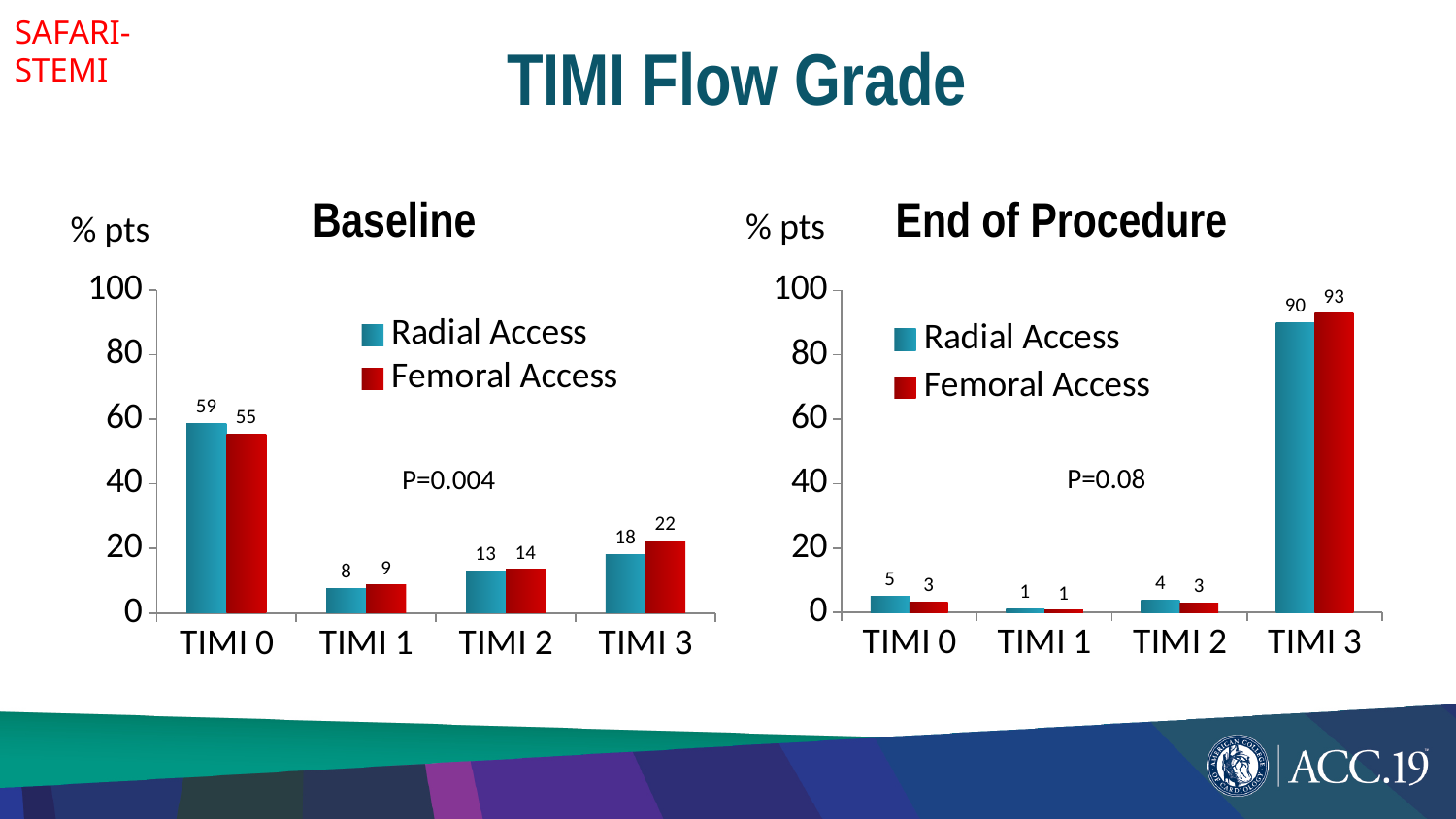
In the Baseline chart, which TIMI category has the highest Radial Access value? TIMI 0 What kind of chart is the End of Procedure chart? Bar chart In the Baseline chart, which is larger at TIMI 3: Radial Access or Femoral Access? Femoral Access In the Baseline chart, what is the value for Radial Access at TIMI 0? 59 In the End of Procedure chart, what is the value for Femoral Access at TIMI 3? 93 In the Baseline chart, what is the difference between the Radial Access and Femoral Access values at TIMI 0? 4 In the End of Procedure chart, which TIMI category has the lowest Femoral Access value? TIMI 1 In the End of Procedure chart, what is the value for Radial Access at TIMI 0? 5 In the Baseline chart, what is the value for Femoral Access at TIMI 3? 22 How many series does the legend of the Baseline chart list? 2 How many TIMI categories are shown on the x axis of the End of Procedure chart? 4 In the End of Procedure chart, what is the difference between the Femoral Access and Radial Access values at TIMI 3? 3